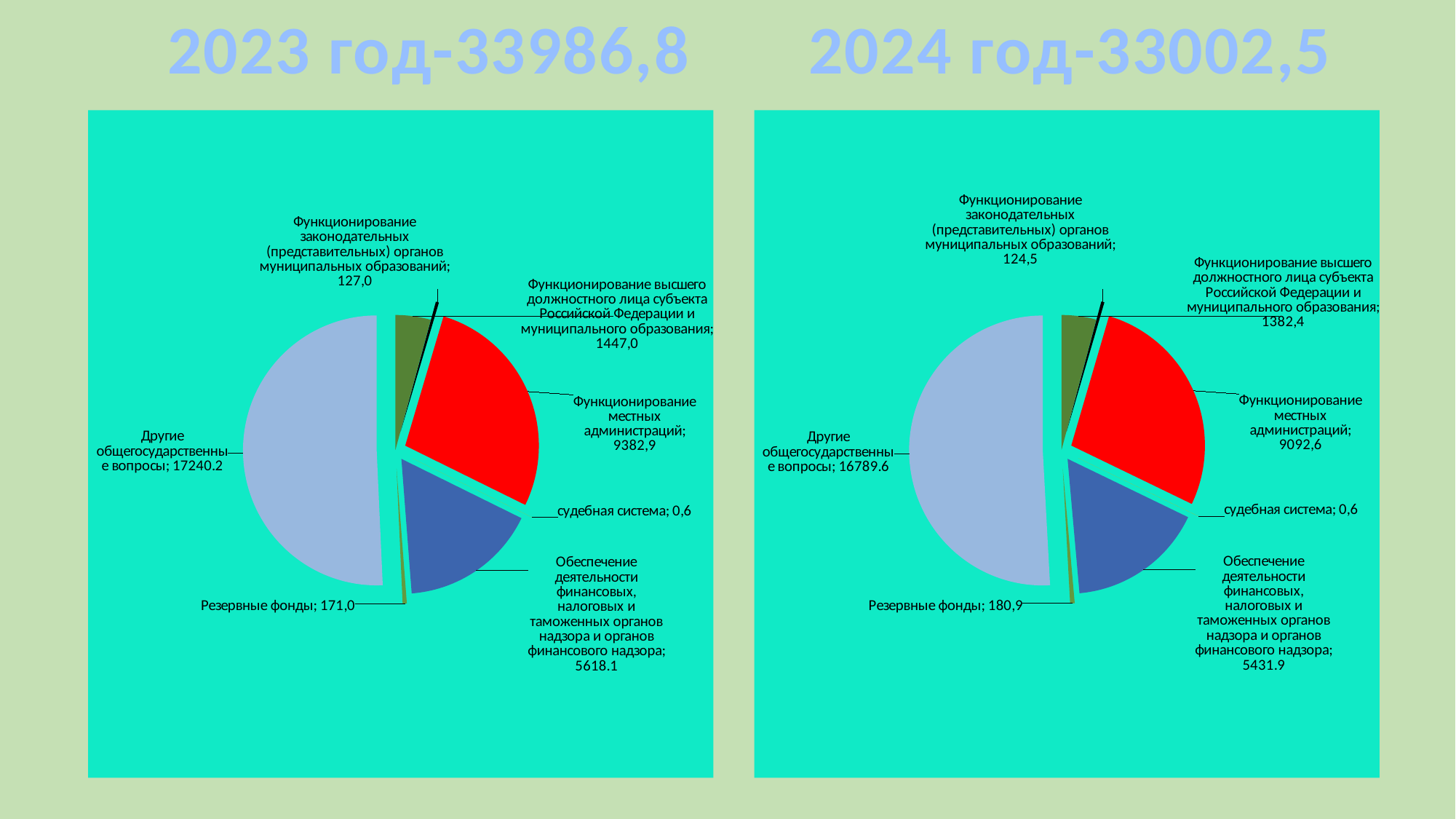
In the 2023 год chart, which is larger: Обеспечение деятельности финансовых, налоговых и таможенных органов надзора и органов финансового надзора or Функционирование местных администраций? Функционирование местных администраций In the 2024 год chart, what is the difference between Другие общегосударственные вопросы and Обеспечение деятельности финансовых, налоговых и таможенных органов надзора и органов финансового надзора? 11357.7 What kind of chart is shown for 2023 год? Pie chart In the 2024 год chart, what is the value for Функционирование высшего должностного лица субъекта Российской Федерации и муниципального образования? 1382,4 In the 2023 год chart, what is the value for Функционирование местных администраций? 9382,9 In the 2024 год chart, what is the value for Резервные фонды? 180,9 Which is larger: Резервные фонды in the 2023 год chart or Резервные фонды in the 2024 год chart? 2024 год In the 2023 год chart, what is the difference between Функционирование местных администраций and Функционирование высшего должностного лица субъекта Российской Федерации и муниципального образования? 7935,9 In the 2024 год chart, which category has the smallest value? судебная система In the 2023 год chart, which category has the largest value? Другие общегосударственные вопросы How many categories are shown in the 2024 год pie chart? 7 What total is shown in the title above the 2024 год chart? 33002,5